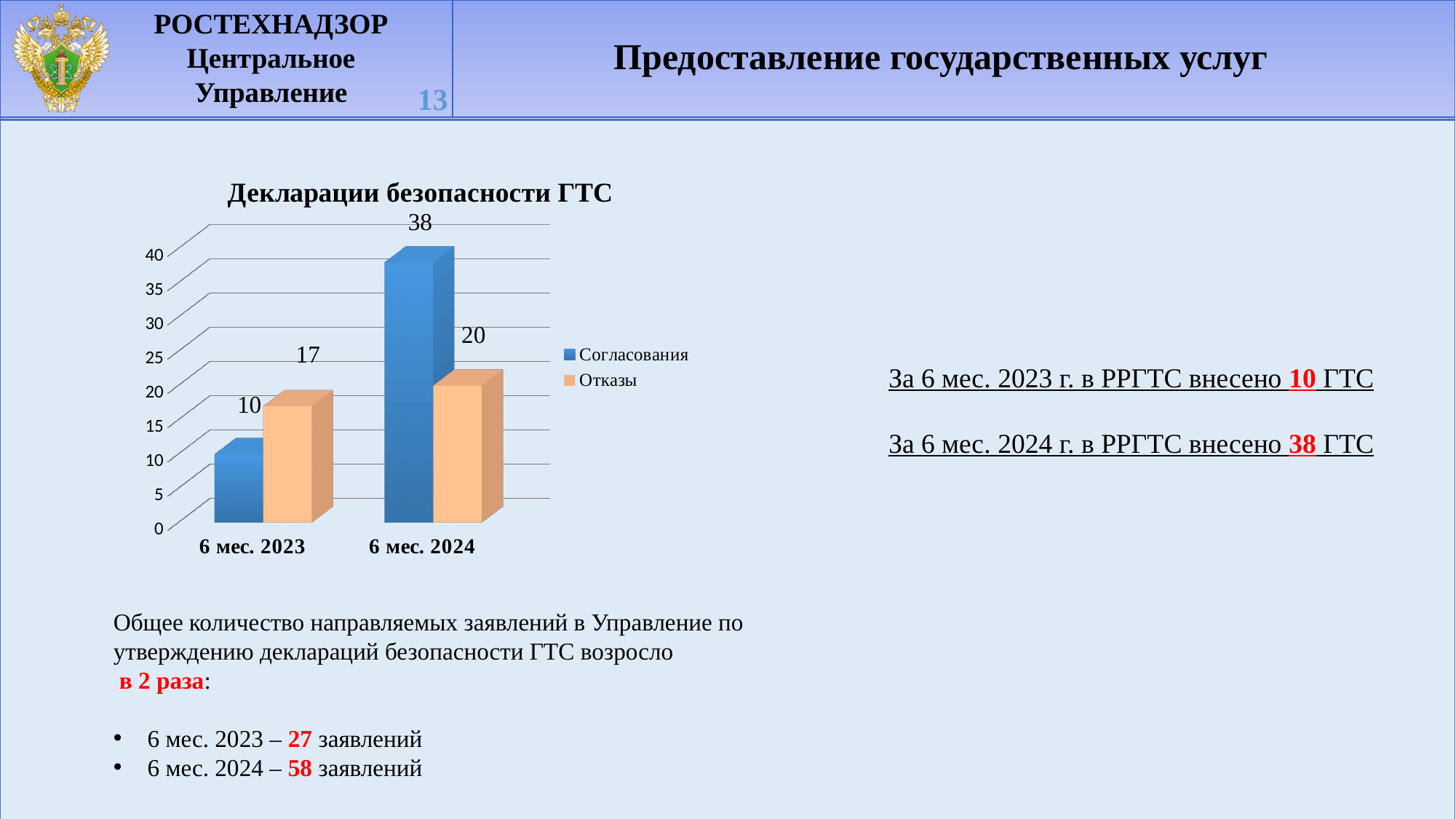
Which category has the highest value for Согласования? 6 мес. 2024 Which category has the lowest value for Отказы? 6 мес. 2023 What kind of chart is shown? bar chart What is the title of the chart? Декларации безопасности ГТС What is the value of Согласования for 6 мес. 2024? 38 How many series does the legend list? 2 What is the value of Отказы for 6 мес. 2024? 20 What is the difference between Согласования in 6 мес. 2024 and 6 мес. 2023? 28 What is the value of Отказы for 6 мес. 2023? 17 What is the value of Согласования for 6 мес. 2023? 10 How many categories are shown on the x axis? 2 Which is larger for 6 мес. 2023: Согласования or Отказы? Отказы